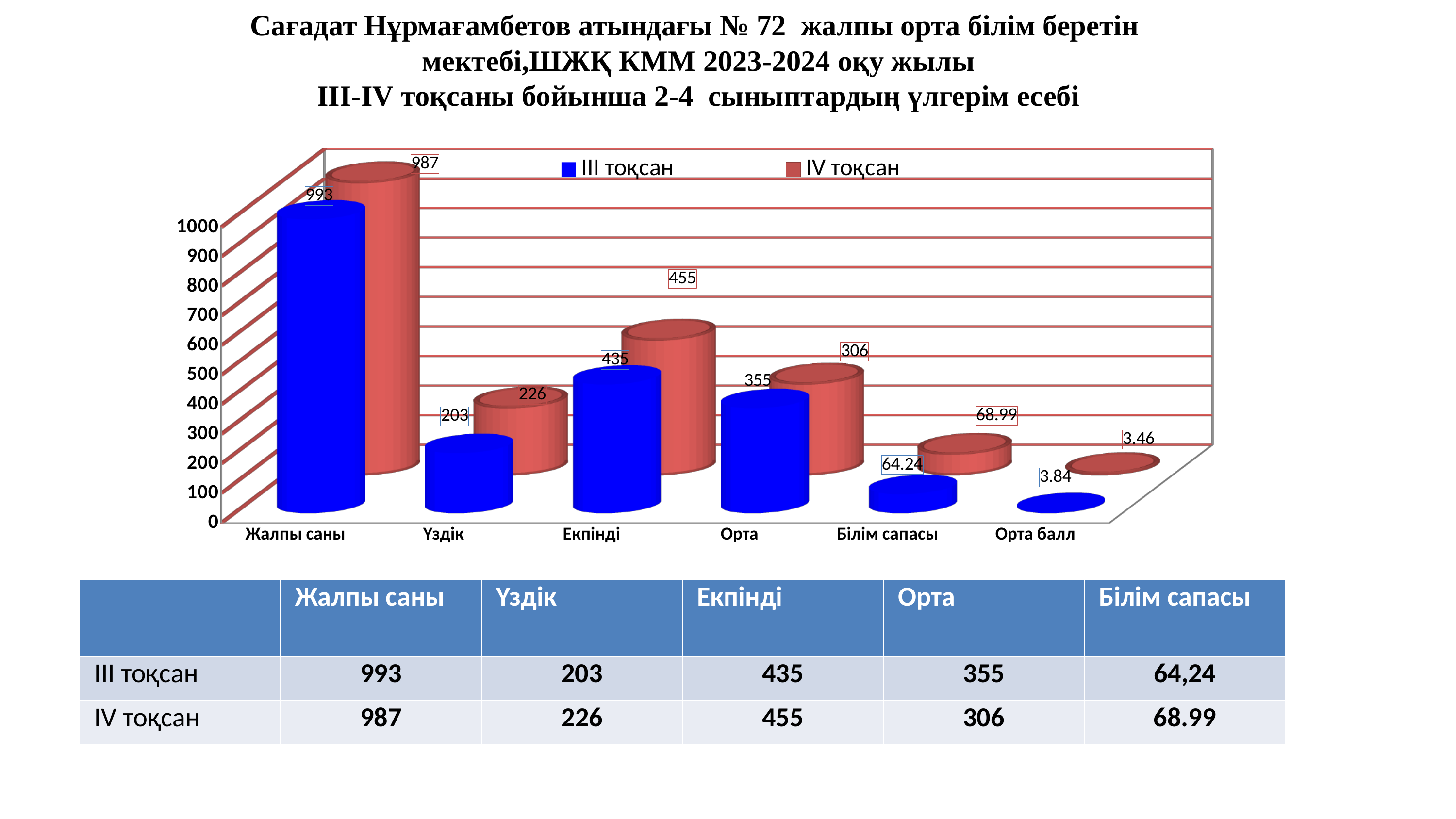
What is the value for Үздік in the IV тоқсан series? 226 Which category has the lowest value in the III тоқсан series? Орта балл What is the difference between the IV тоқсан and III тоқсан values for Екпінді? 20 Is the value for Үздік in the III тоқсан series greater or less than 300? less Which category has the highest value in the IV тоқсан series? Жалпы саны What is the value for Жалпы саны in the III тоқсан series? 993 How many categories are shown on the x axis of the chart? 6 What is the value for Білім сапасы in the IV тоқсан series? 68.99 What is the value for Орта балл in the III тоқсан series? 3.84 How many series does the chart legend list? 2 What kind of chart is shown on the slide? bar chart For Орта, which series has the larger value, III тоқсан or IV тоқсан? III тоқсан